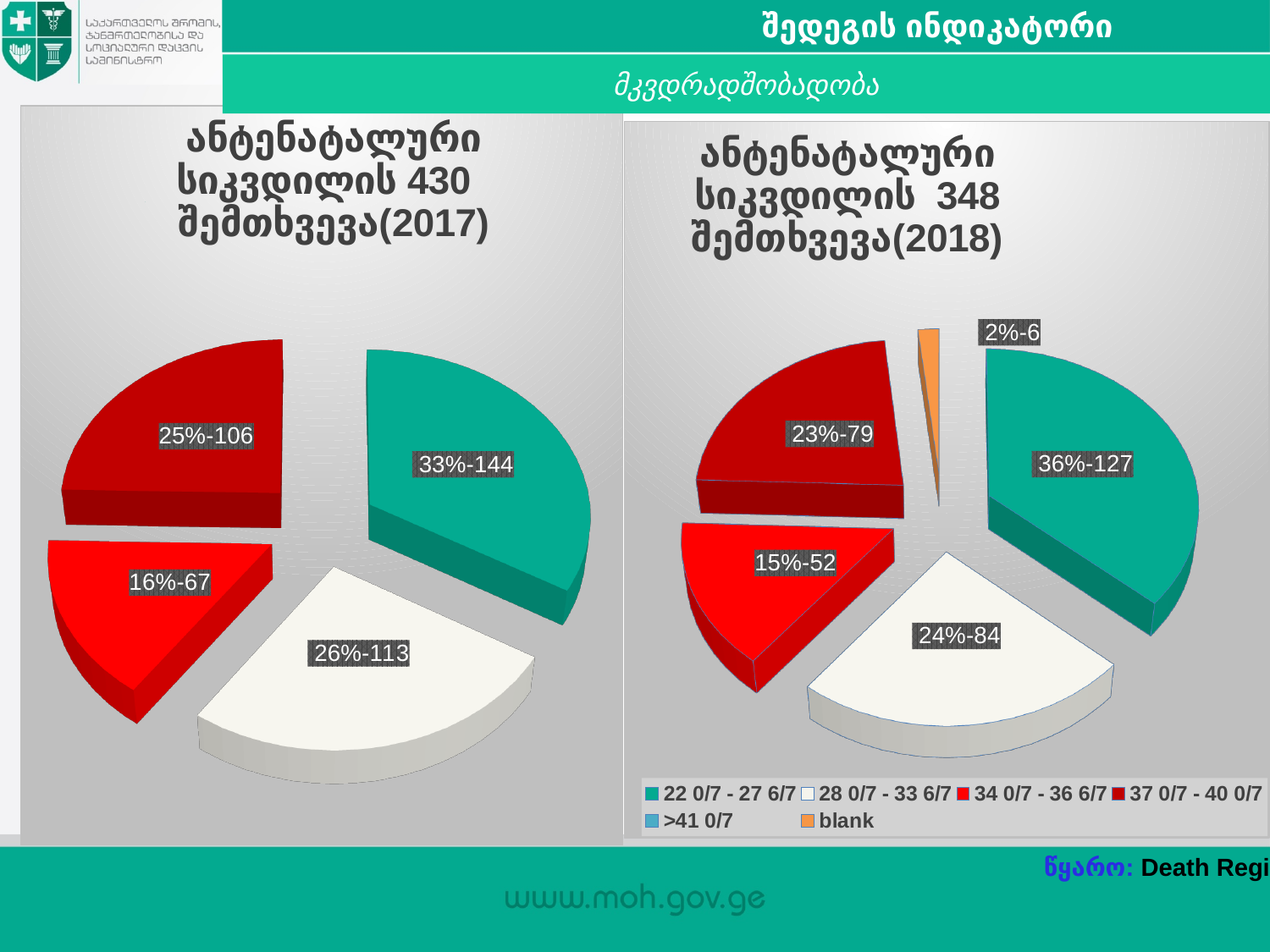
In the legend of the right chart, which category is shown in orange? blank On the right pie chart (2018), what is the label shown on the slice for the 22 0/7 - 27 6/7 category? 36%-127 On the right pie chart (2018), which category has the smallest slice? blank (2%-6) How many entries does the legend below the right chart list? 6 On the left pie chart (2017), what is the label shown on the bright red slice? 16%-67 On the right pie chart (2018), what is the difference in count between the 22 0/7 - 27 6/7 slice and the 28 0/7 - 33 6/7 slice? 43 How many slices does the right pie chart (2018) have? 5 How many slices does the left pie chart (2017) have? 4 On the right pie chart (2018), what share of the pie does the 34 0/7 - 36 6/7 category represent? 15% On the left pie chart (2017), which slice is the largest? The teal slice, 33%-144 What type of chart is used on this slide? Pie chart On the left pie chart (2017), which slice has the larger count: the white slice or the dark red slice? The white slice (113)